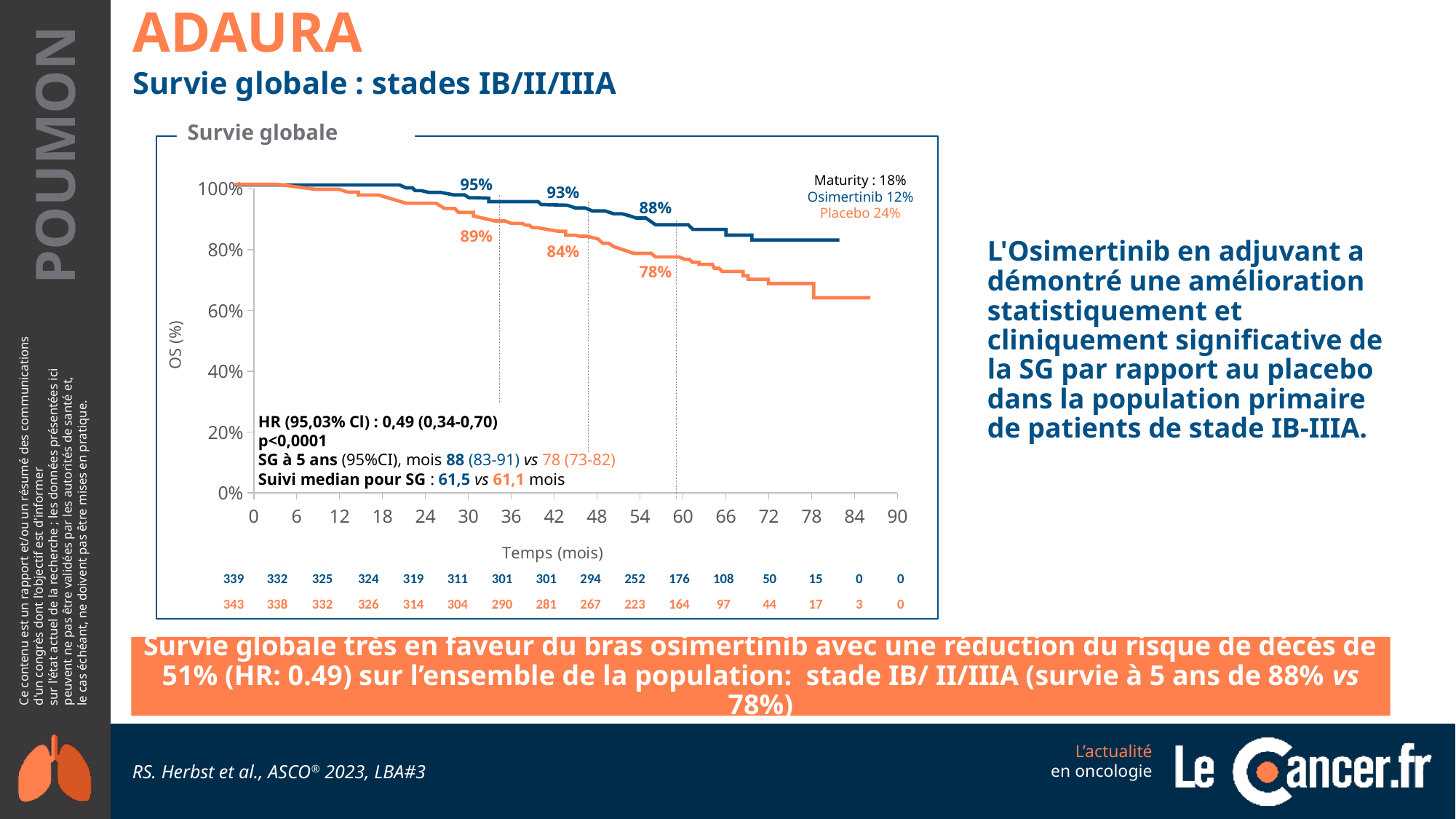
What kind of chart is shown under the title 'Survie globale'? line chart Is the placebo curve at 84 months greater or less than 80%? less What is the 5-year overall survival (SG à 5 ans) for the placebo arm? 78% What is the 5-year overall survival (SG à 5 ans) for the osimertinib arm? 88% Do the survival curves rise or fall as time (mois) increases? fall What is the highest labelled value on the osimertinib curve? 95% What is the difference in 5-year overall survival between osimertinib (88%) and placebo (78%)? 10 percentage points What is the lowest labelled value on the placebo curve? 78% How many series (treatment arms) are plotted on the survival chart? 2 How many patients were at risk at time 0 in the osimertinib arm (blue row)? 339 Which arm has the higher overall survival at 5 years, osimertinib or placebo? Osimertinib What hazard ratio (HR) is printed on the chart? 0,49 (0,34-0,70)